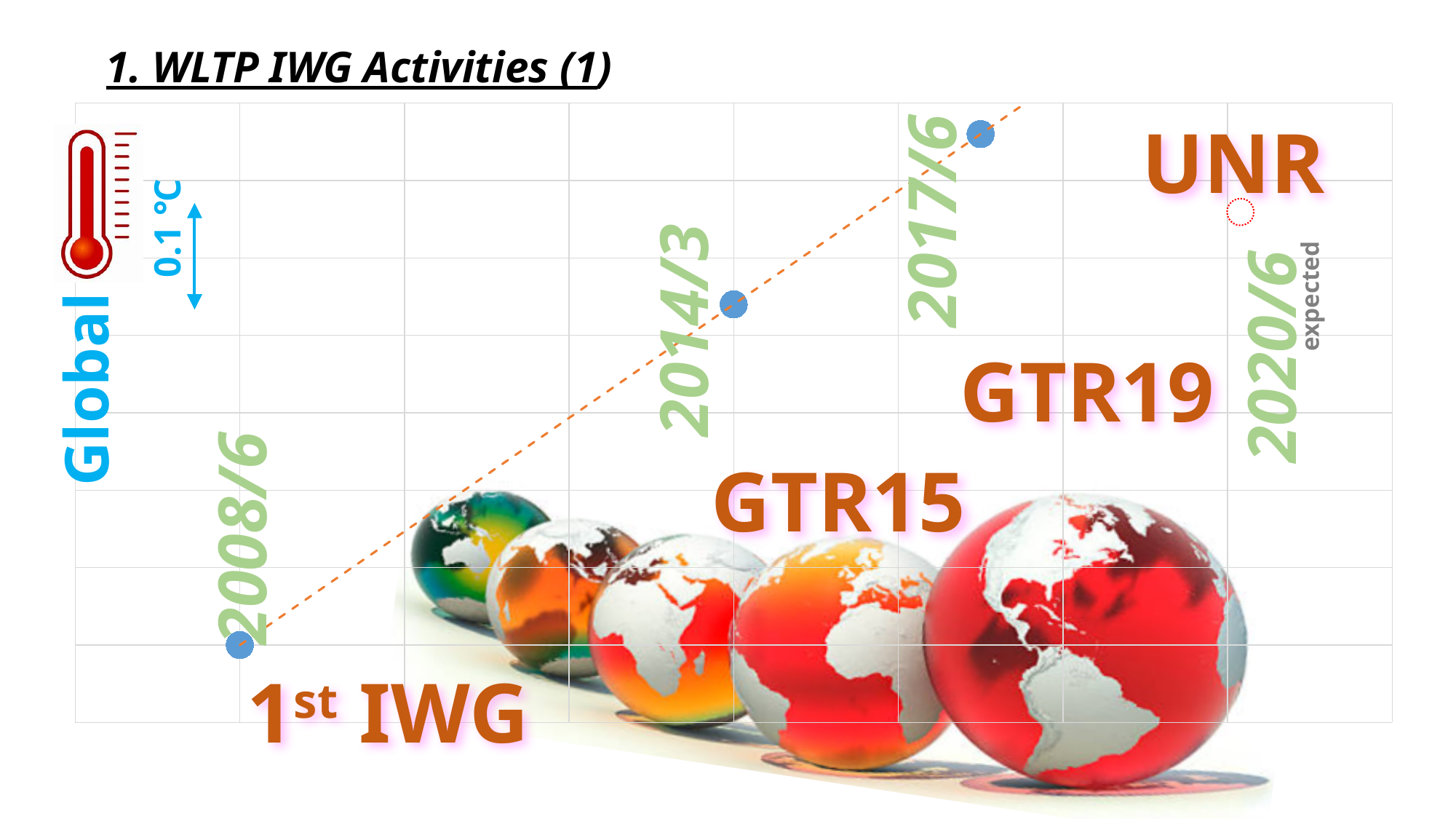
Which milestone label is attached to the 2008/6 point? 1st IWG What kind of chart is shown on the slide? scatter chart with a dashed trend line Which plotted point is the lowest on the chart? 2008/6 (1st IWG) Which milestone label is attached to the 2017/6 point? GTR19 What temperature step is shown next to the thermometer on the vertical axis? 0.1 °C Do the plotted points rise or fall from 2008/6 to 2017/6? rise Which milestone label is attached to the 2020/6 point? UNR Is the point for 2017/6 higher or lower than the point for 2014/3? higher Which date on the chart is marked as 'expected'? 2020/6 How many solid blue data points are plotted on the chart? 3 Which solid plotted point is the highest on the chart? 2017/6 (GTR19) Which milestone label is attached to the 2014/3 point? GTR15